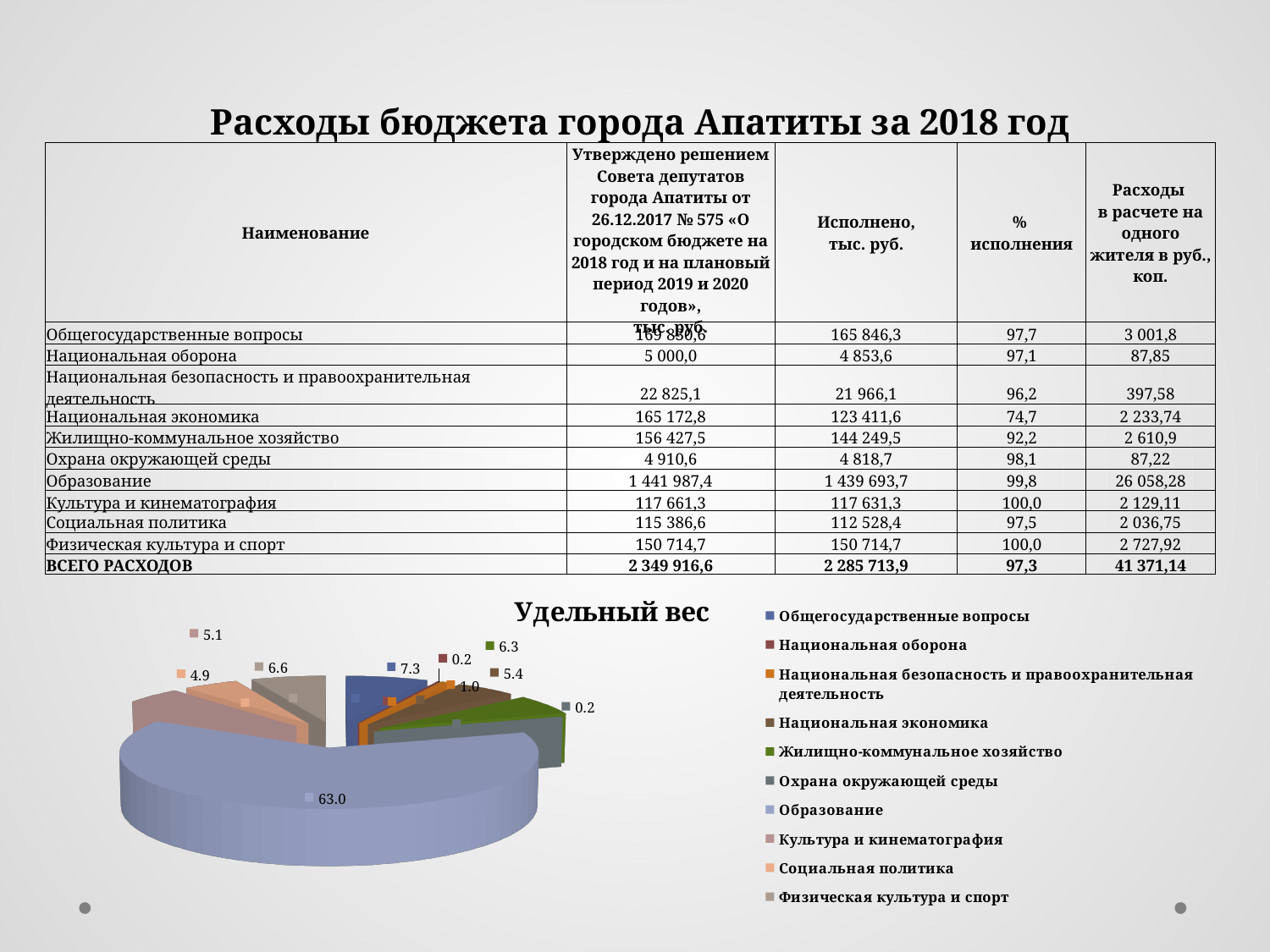
In the "Удельный вес" pie chart, what is the value shown for Физическая культура и спорт? 6.6 What is the title of the pie chart on the slide? Удельный вес In the "Удельный вес" pie chart, what is the value shown for Жилищно-коммунальное хозяйство? 6.3 In the "Удельный вес" pie chart, what is the value shown for Общегосударственные вопросы? 7.3 In the "Удельный вес" pie chart, what is the value shown for Образование? 63.0 In the "Удельный вес" pie chart, what is the value shown for Национальная безопасность и правоохранительная деятельность? 1.0 In the "Удельный вес" pie chart, which category has the largest slice? Образование In the "Удельный вес" pie chart, how many categories does the legend list? 10 In the "Удельный вес" pie chart, which is larger: the slice for Общегосударственные вопросы or the slice for Национальная экономика? Общегосударственные вопросы In the "Удельный вес" pie chart, what is the difference between the values for Образование and Общегосударственные вопросы? 55.7 What kind of chart is shown under the title "Удельный вес"? pie chart In the "Удельный вес" pie chart, what is the value shown for Национальная экономика? 5.4